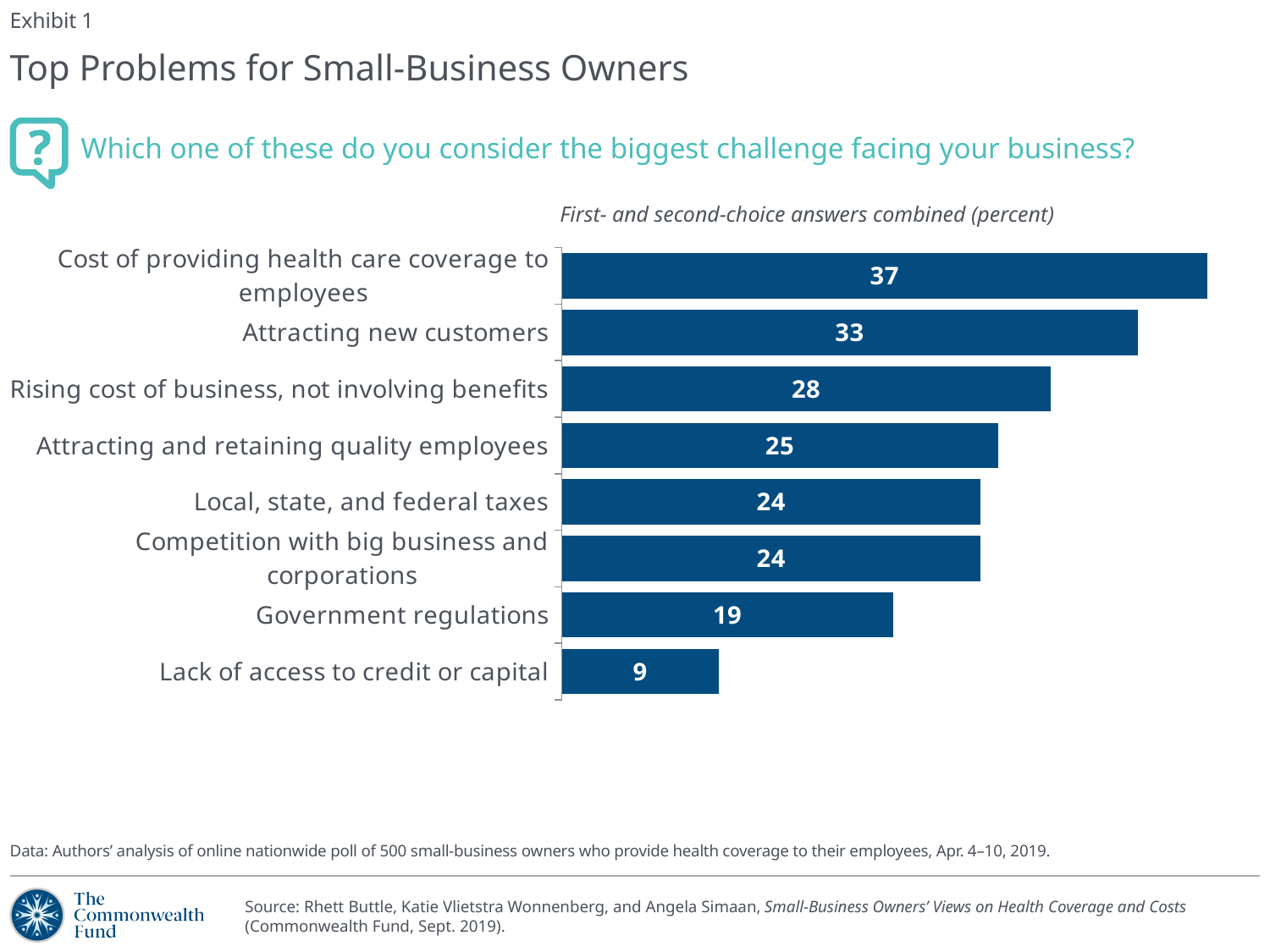
What is the value shown for Government regulations? 19 What kind of chart is shown on the slide? Bar chart What is the value shown for Rising cost of business, not involving benefits? 28 What percentage of small-business owners chose cost of providing health care coverage to employees as a top challenge? 37 What is the value shown for Attracting new customers? 33 How many categories are shown in the chart? 8 Which is larger: the value for Attracting and retaining quality employees or the value for Government regulations? Attracting and retaining quality employees What is the difference between the values for Cost of providing health care coverage to employees and Attracting new customers? 4 What is the difference between the values for Government regulations and Lack of access to credit or capital? 10 What is the title of the chart on the slide? Top Problems for Small-Business Owners Which category has the highest value in the chart? Cost of providing health care coverage to employees Which category has the lowest value in the chart? Lack of access to credit or capital